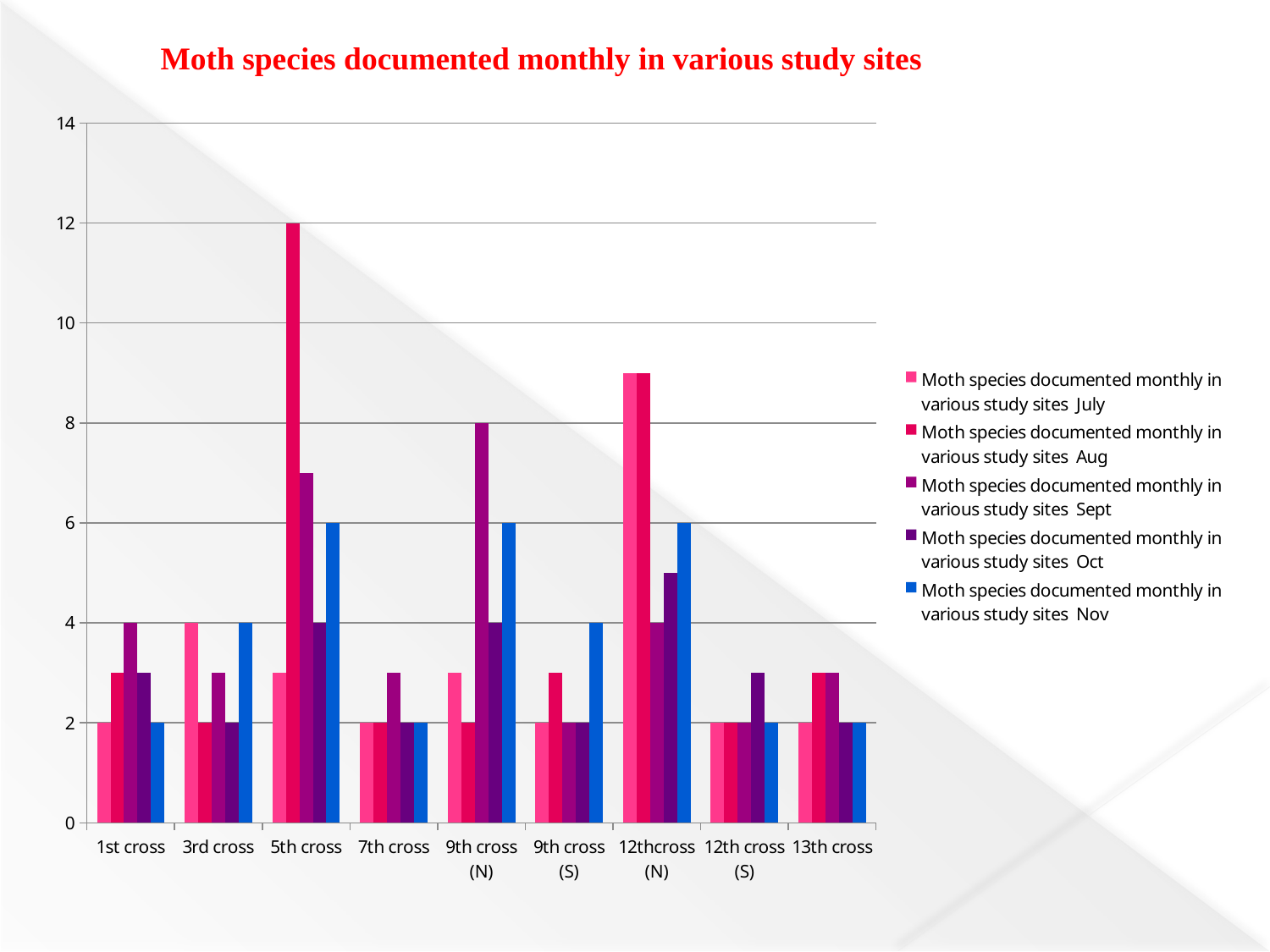
How many series does the legend list? 5 Which study site has the highest July value? 12thcross (N) What is the Aug value for 5th cross? 12 What kind of chart is shown on the slide? bar chart How many study sites (categories) are shown on the x axis? 9 What is the difference between the Aug value for 5th cross and the Aug value for 12thcross (N)? 3 What is the title of the chart? Moth species documented monthly in various study sites What is the Nov value for 5th cross? 6 Which is larger, the Sept value for 5th cross or the Sept value for 9th cross (N)? 9th cross (N) Is the Aug value for 5th cross greater or less than 10? greater What is the Sept value for 9th cross (N)? 8 Which study site has the highest Aug value? 5th cross